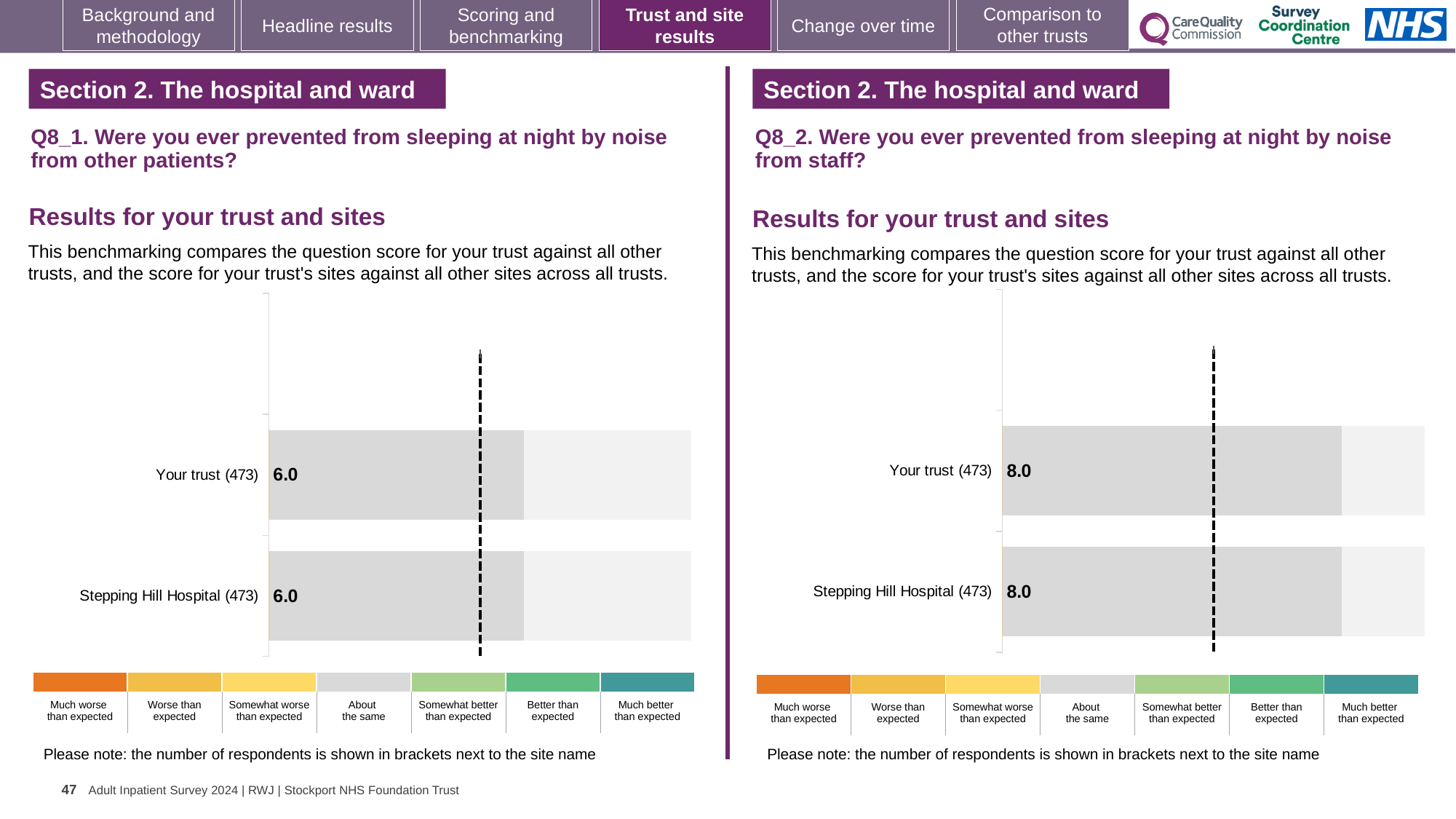
On the Q8_2 chart (right), what is the difference between the score for Your trust and the score for Stepping Hill Hospital? 0.0 What kind of chart is used for the Q8_2 results (right)? Bar chart How many respondents are shown in brackets next to Stepping Hill Hospital on the Q8_1 chart (left)? 473 Which benchmark category does the grey colour of the bars on the Q8_2 chart (right) correspond to in the key? About the same How many bars are plotted on the Q8_2 chart (right)? 2 On the Q8_2 chart (right), what is the score for Stepping Hill Hospital (473)? 8.0 How many bars are plotted on the Q8_1 chart (left)? 2 How many benchmark categories does the colour key below the Q8_1 chart (left) list? 7 On the Q8_1 chart (left), what is the score for Stepping Hill Hospital (473)? 6.0 On the Q8_1 chart (left), what is the score for Your trust (473)? 6.0 On the Q8_2 chart (right), what is the score for Your trust (473)? 8.0 On the Q8_1 chart (left), what is the difference between the score for Your trust and the score for Stepping Hill Hospital? 0.0